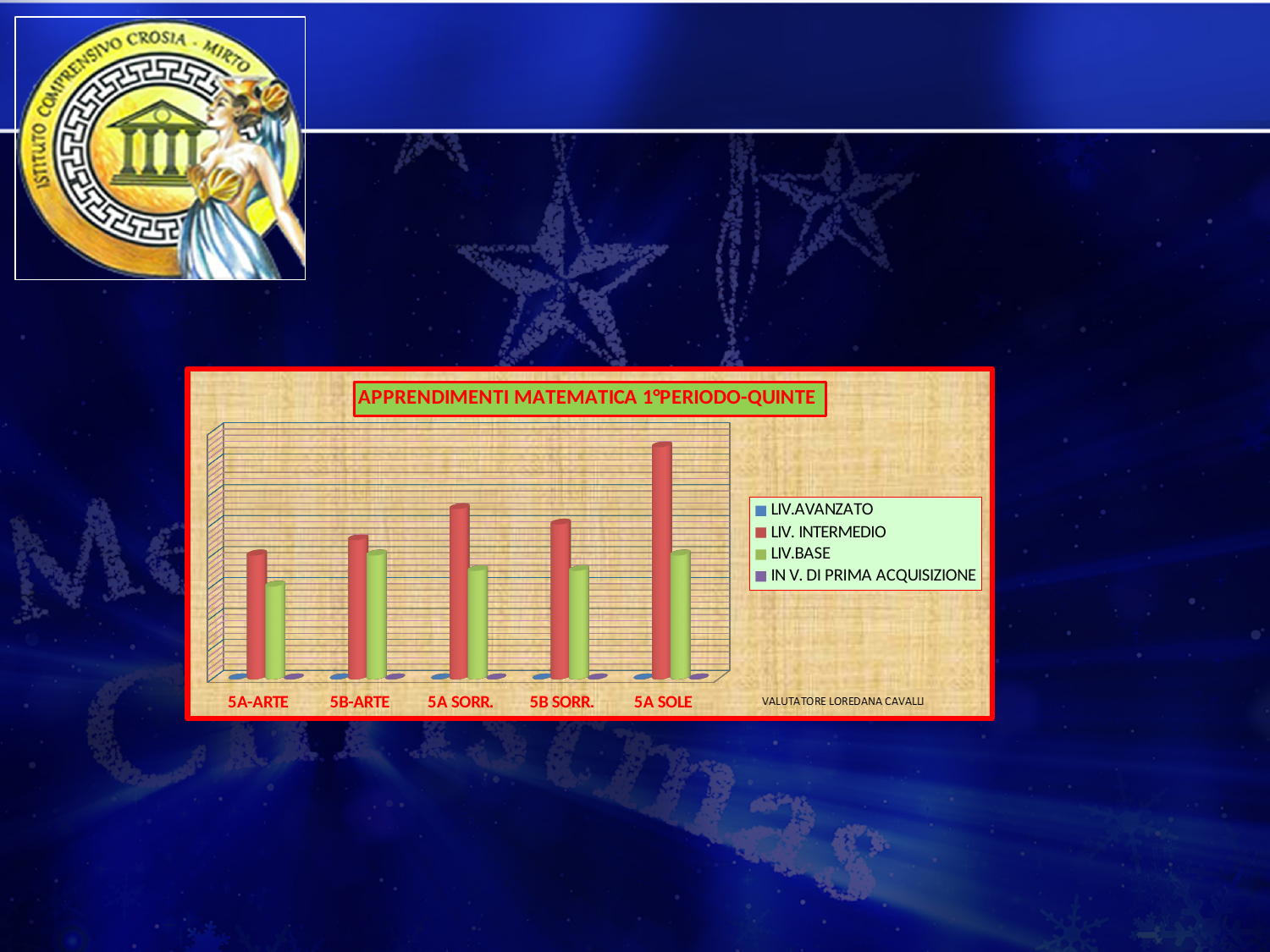
Which class has the lowest LIV. INTERMEDIO bar? 5A-ARTE Which class has the lowest LIV.BASE bar? 5A-ARTE What is the title of the chart? APPRENDIMENTI MATEMATICA 1°PERIODO-QUINTE Which class has the larger LIV. INTERMEDIO bar: 5A-ARTE or 5B-ARTE? 5B-ARTE For 5A SOLE, which is larger: LIV. INTERMEDIO or LIV.BASE? LIV. INTERMEDIO Which class has the larger LIV. INTERMEDIO bar: 5A SORR. or 5B SORR.? 5A SORR. How many series does the legend list? 4 Which class has the highest LIV. INTERMEDIO bar? 5A SOLE How many classes (categories) are shown on the x axis? 5 Which legend entry is shown in green? LIV.BASE What kind of chart is shown on the slide? bar chart